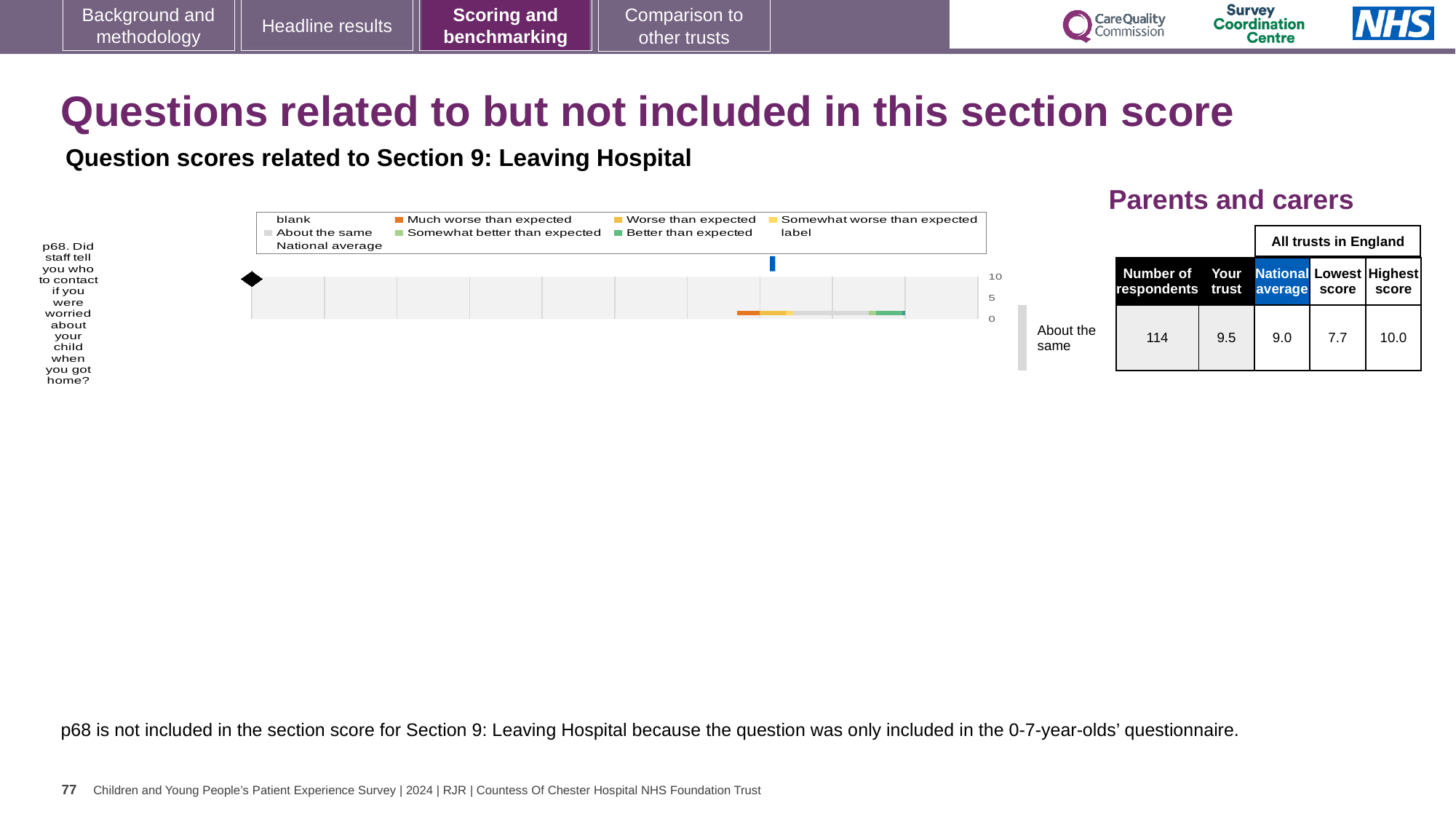
What kind of chart is used to show the p68 question score? bar chart How many questions are plotted in the chart? 1 Which is larger for p68: the trust's score or the national average? Your trust Which benchmark category is the trust's score for p68 placed in? About the same By how much does the trust's score for p68 exceed the national average? 0.5 How many respondents answered p68? 114 What is the highest tick value shown on the chart's score axis? 10 What is the national average score for p68? 9.0 What is the highest score among all trusts in England for p68? 10.0 What is the difference between the highest and lowest scores for p68 across all trusts in England? 2.3 What is the 'Your trust' score for p68? 9.5 What is the lowest score among all trusts in England for p68? 7.7